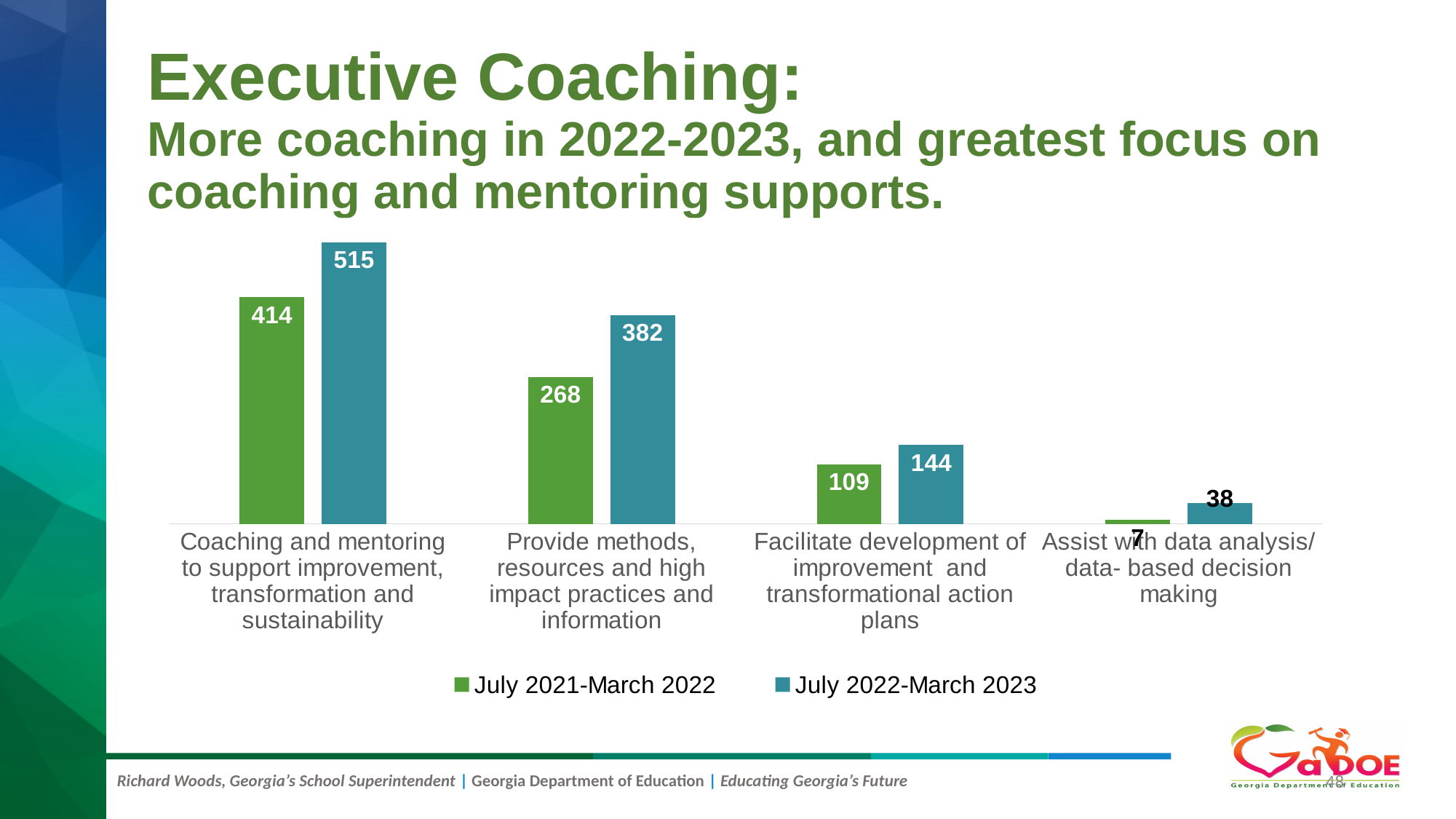
How many categories are shown on the x axis? 4 What is the value for 'Provide methods, resources and high impact practices and information' in July 2021-March 2022? 268 Which colour represents the July 2022-March 2023 series? Teal blue What kind of chart is shown on the slide? Bar chart What is the difference between the two series for 'Facilitate development of improvement and transformational action plans'? 35 Which category has the lowest value in July 2021-March 2022? Assist with data analysis/ data- based decision making What is the value for 'Coaching and mentoring to support improvement, transformation and sustainability' in July 2022-March 2023? 515 What is the difference between the July 2022-March 2023 and July 2021-March 2022 values for 'Provide methods, resources and high impact practices and information'? 114 Which is larger for 'Coaching and mentoring to support improvement, transformation and sustainability': July 2021-March 2022 or July 2022-March 2023? July 2022-March 2023 How many series does the legend list? 2 What is the value for 'Assist with data analysis/ data- based decision making' in July 2022-March 2023? 38 Which category has the highest value in July 2022-March 2023? Coaching and mentoring to support improvement, transformation and sustainability